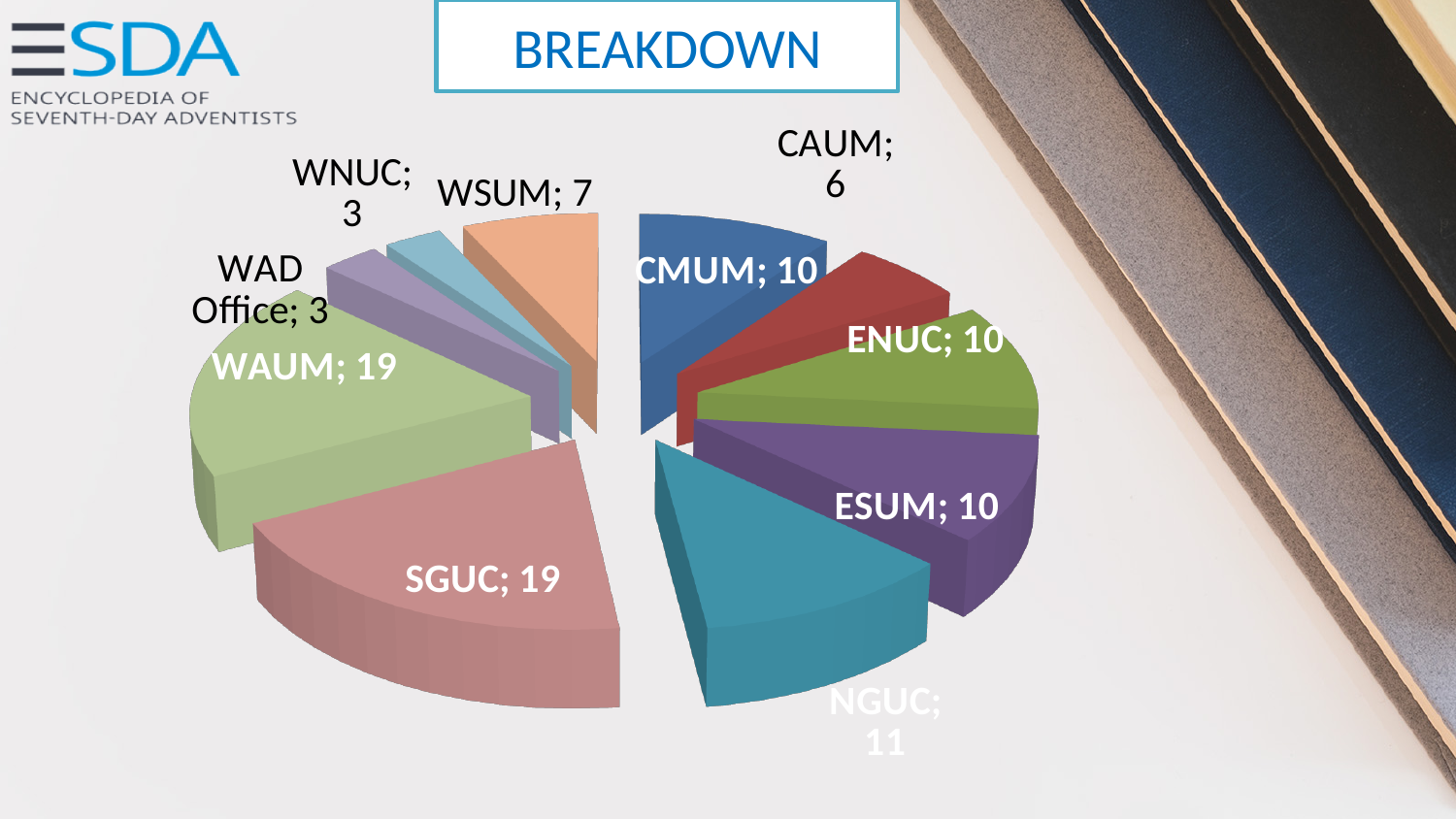
How many slices does the pie chart have? 10 What is the value for NGUC in the pie chart? 11 What is the title shown above the chart? BREAKDOWN What is the value for WSUM in the pie chart? 7 Which has a larger value, NGUC or ESUM? NGUC What kind of chart is shown on the slide? Pie chart What is the value for SGUC in the pie chart? 19 What is the largest value shown in the pie chart? 19 What is the value for CAUM in the pie chart? 6 What is the difference between the values for SGUC and NGUC? 8 What is the smallest value shown in the pie chart? 3 What is the value for WAD Office in the pie chart? 3